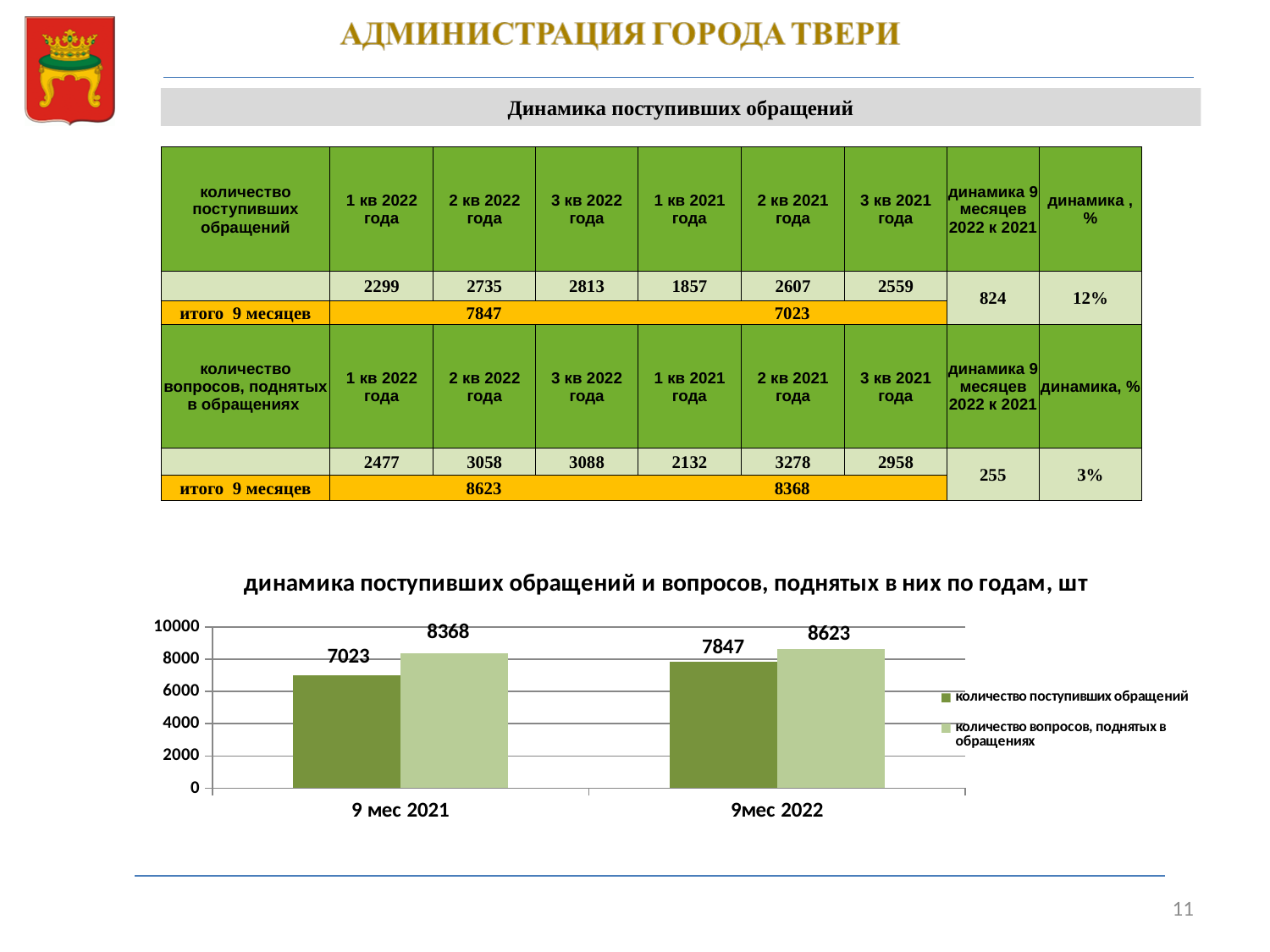
How many series does the legend list? 2 What is the value of "количество вопросов, поднятых в обращениях" for 9мес 2022? 8623 What is the difference between "количество поступивших обращений" for 9мес 2022 and for 9 мес 2021? 824 How many categories are shown on the x axis? 2 What is the value of "количество поступивших обращений" for 9мес 2022? 7847 What is the title of the chart? динамика поступивших обращений и вопросов, поднятых в них по годам, шт What kind of chart is shown on the slide? bar chart What is the value of "количество вопросов, поднятых в обращениях" for 9 мес 2021? 8368 What is the value of "количество поступивших обращений" for 9 мес 2021? 7023 Which is larger for 9 мес 2021: "количество поступивших обращений" or "количество вопросов, поднятых в обращениях"? количество вопросов, поднятых в обращениях Does "количество поступивших обращений" rise or fall from 9 мес 2021 to 9мес 2022? rise What is the difference between "количество вопросов, поднятых в обращениях" for 9мес 2022 and for 9 мес 2021? 255